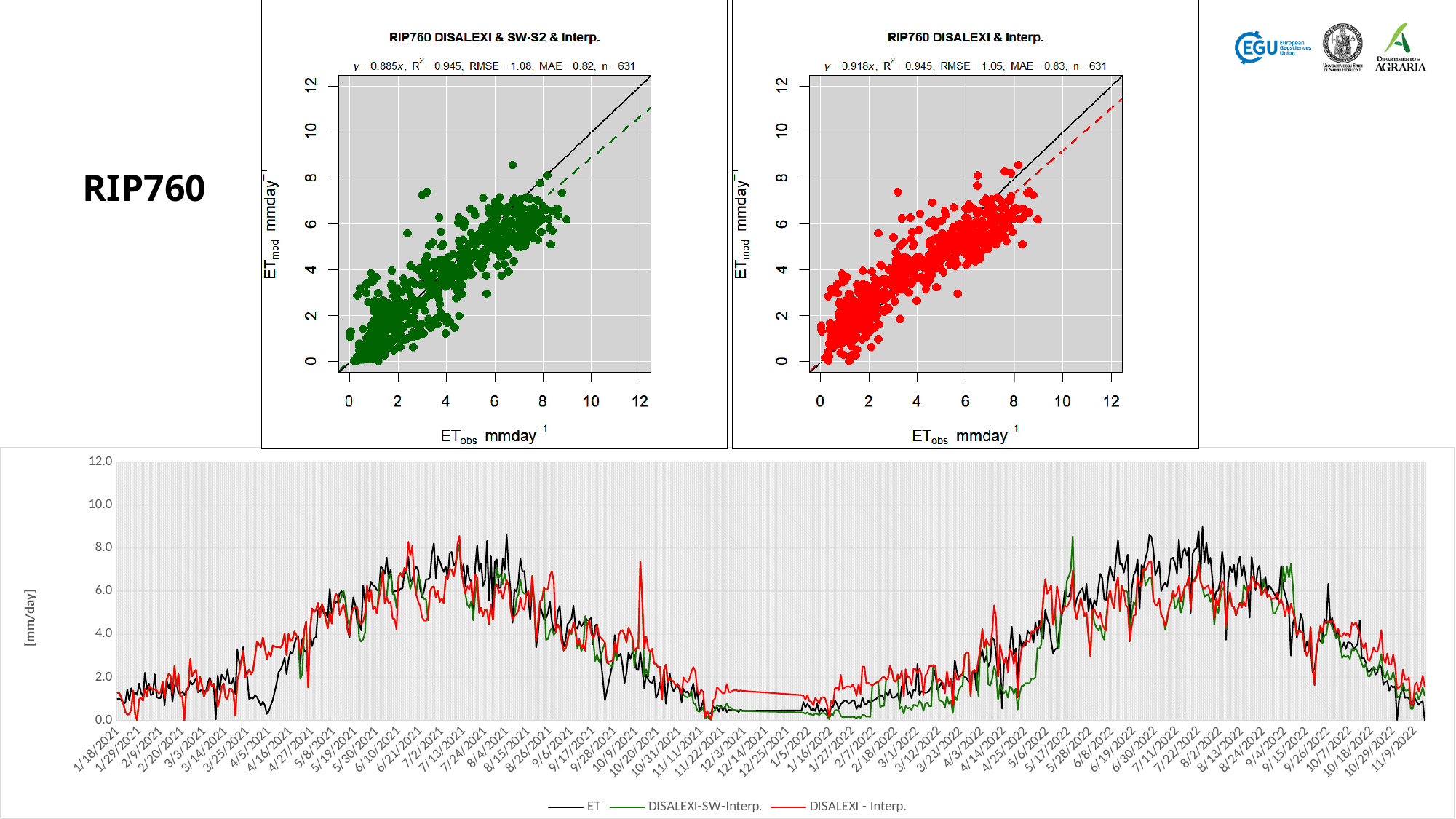
How many series does the legend of the bottom chart list? 3 What colour are the data points in the top-right chart 'RIP760 DISALEXI & Interp.'? red In the top-left chart 'RIP760 DISALEXI & SW-S2 & Interp.', what is the R² value printed above the plot? 0.945 In the bottom chart, is the highest value reached by the ET series greater or less than 10.0? less What is the difference between the MAE of the top-right chart 'RIP760 DISALEXI & Interp.' and the MAE of the top-left chart 'RIP760 DISALEXI & SW-S2 & Interp.'? 0.01 What kind of chart is the bottom chart with the date axis? line chart In the top-right chart 'RIP760 DISALEXI & Interp.', what is the value of n printed above the plot? 631 In the top-right chart 'RIP760 DISALEXI & Interp.', what is the fitted regression equation printed above the plot? y = 0.918x What is the y-axis label of the bottom chart? [mm/day] What kind of chart is the top-left chart titled 'RIP760 DISALEXI & SW-S2 & Interp.'? scatter plot Which of the two scatter plots reports the lower RMSE? RIP760 DISALEXI & Interp. In the top-left chart 'RIP760 DISALEXI & SW-S2 & Interp.', what is the RMSE value printed above the plot? 1.08